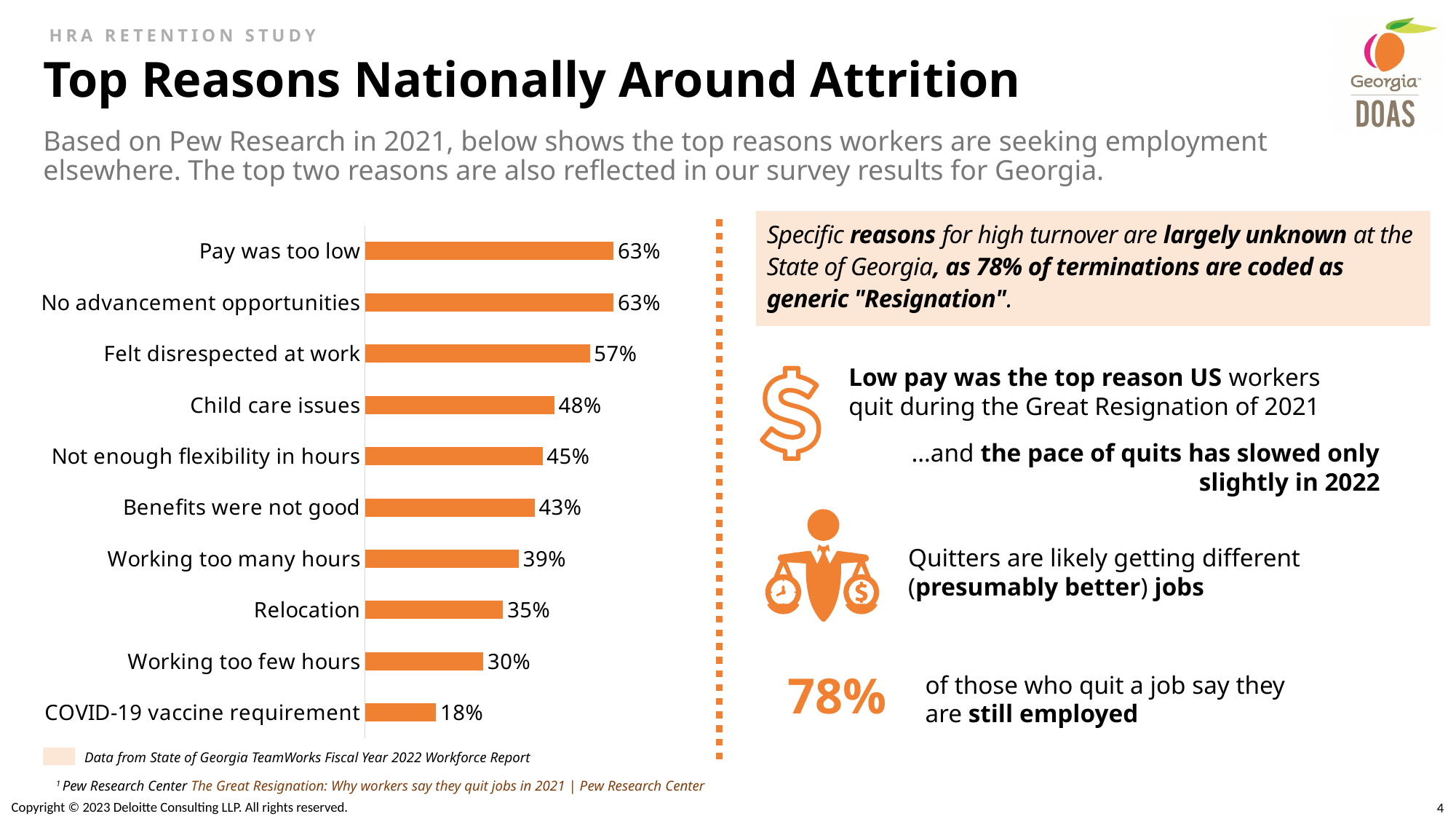
What colour are the bars in the chart? Orange Which is larger: "Not enough flexibility in hours" or "Benefits were not good"? Not enough flexibility in hours What is the value for "Relocation"? 35% What type of chart is shown on the slide? Bar chart What percentage is shown for "Felt disrespected at work"? 57% Which reason has the lowest percentage in the chart? COVID-19 vaccine requirement What is the difference between "Pay was too low" and "Benefits were not good"? 20% What is the difference between "Working too many hours" and "Working too few hours"? 9% What is the highest percentage shown in the chart? 63% What percentage is shown for "COVID-19 vaccine requirement"? 18% What is the value for "Child care issues"? 48% How many reasons are listed in the bar chart? 10